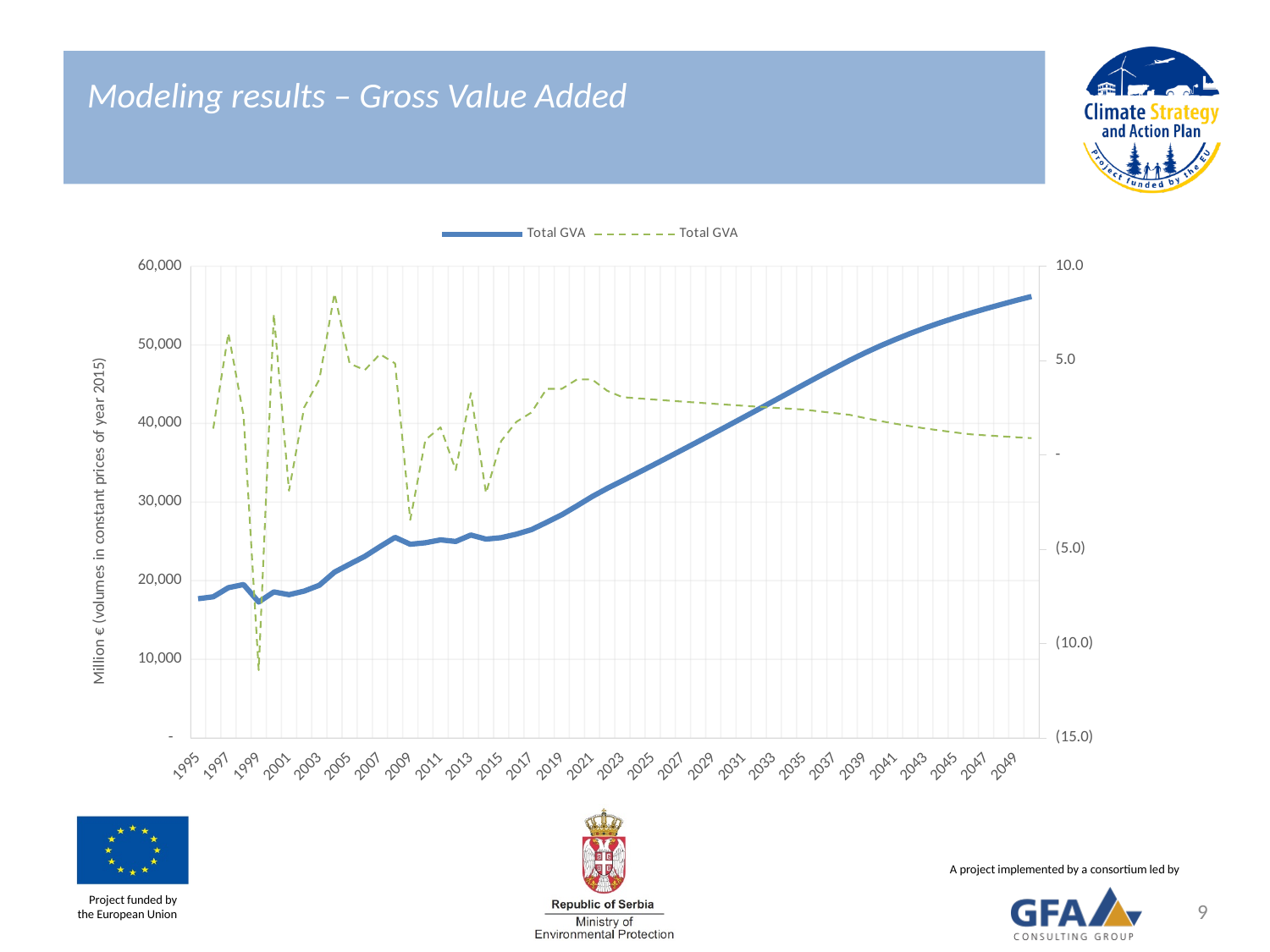
Is the value of the solid blue Total GVA line in 2009 greater or less than 30,000? less What type of chart is shown on the slide? line chart In which year does the dashed green Total GVA line reach its lowest value? 1999 Which is larger for the solid blue Total GVA line: the value in 1995 or the value in 2049? 2049 How many series does the legend list? 2 Does the dashed green Total GVA line rise or fall between 2021 and 2049? falls Does the solid blue Total GVA line rise or fall between 2015 and 2049? rises What is the title of the slide containing the chart? Modeling results – Gross Value Added What is the label of the left vertical axis? Million € (volumes in constant prices of year 2015) Is the value of the solid blue Total GVA line in 1995 greater or less than 20,000? less In which year does the solid blue Total GVA line reach its highest value? 2050 Is the value of the solid blue Total GVA line in 2049 greater or less than 50,000? greater